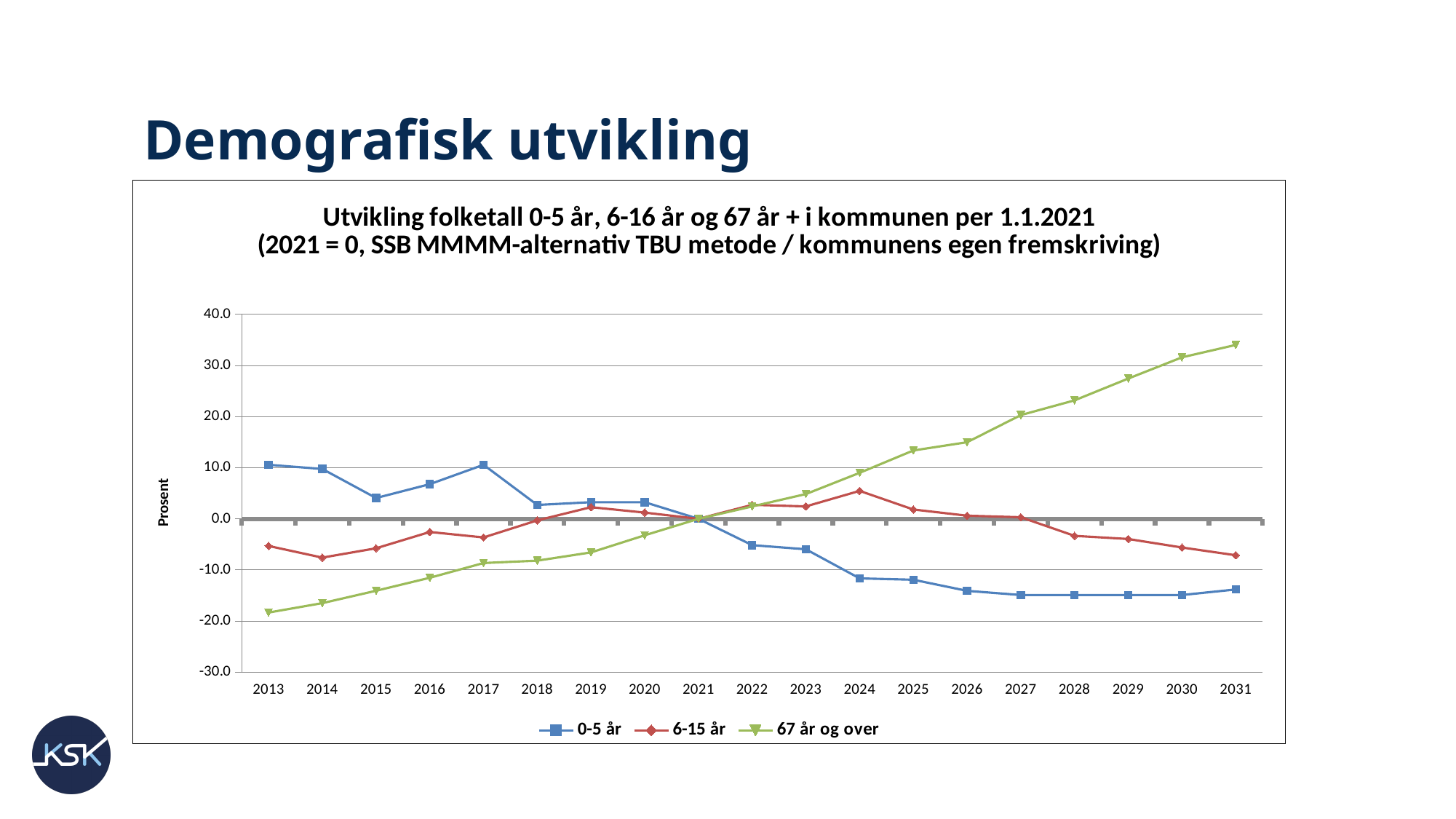
Is the value for 67 år og over in 2013 greater or less than -10? less Is the value for 67 år og over in 2031 greater or less than 30? greater How many series does the legend list? 3 How many years are shown along the x axis? 19 Which series has the lowest value in 2013? 67 år og over What is the label on the y axis? Prosent What kind of chart is shown on the slide? line chart Is the value for 0-5 år in 2027 greater or less than -10? less In 2031, which is larger: the value for 0-5 år or the value for 6-15 år? 6-15 år Does the 67 år og over series rise or fall from 2013 to 2031? rise Which series has the highest value in 2013? 0-5 år Which series has the highest value in 2031? 67 år og over